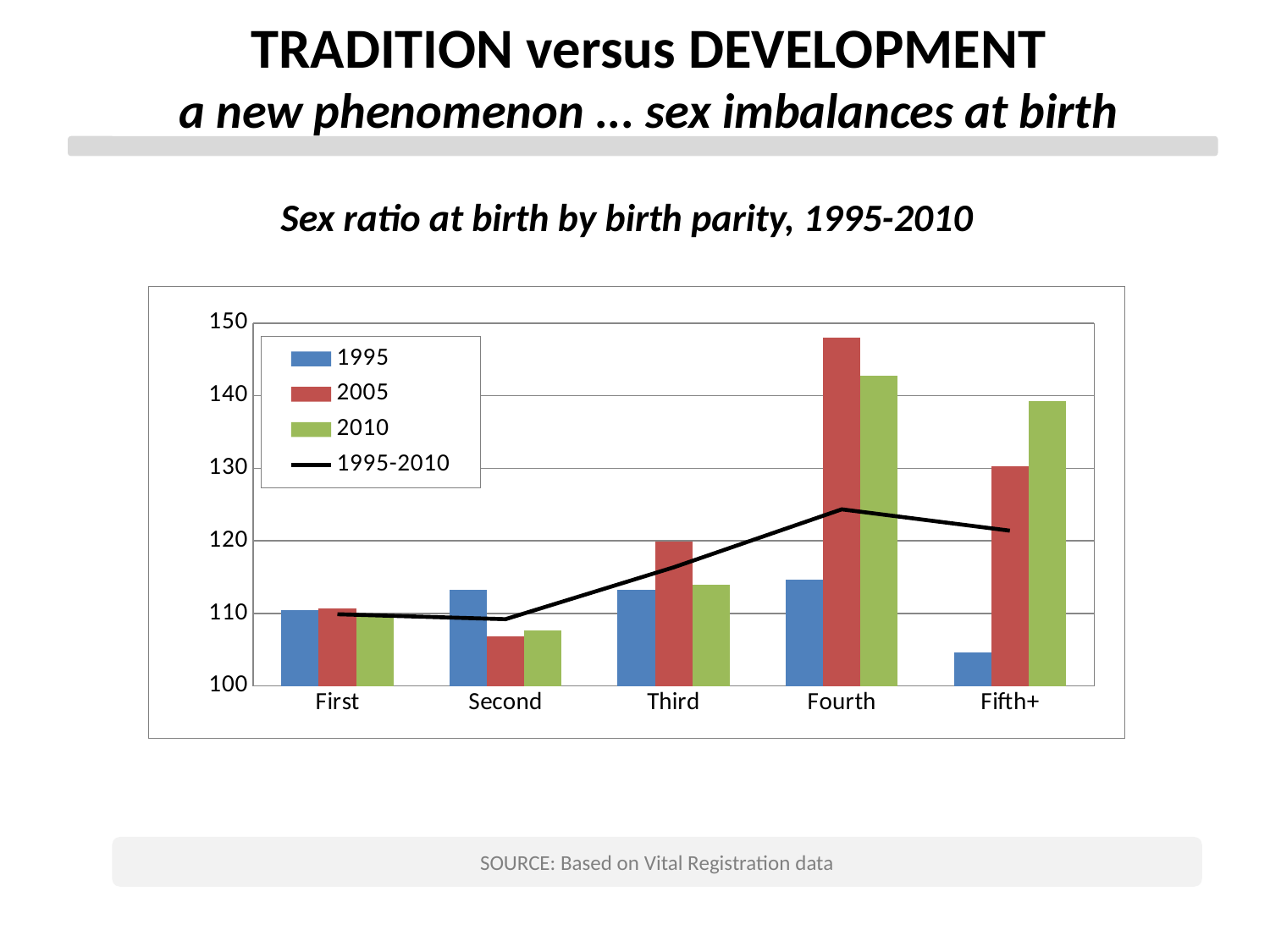
Is the 2005 value for Fourth greater or less than 140? greater For Fifth+, which series has the larger value, 2005 or 2010? 2010 What kind of chart is shown on the slide? A bar chart with a line Is the 2010 value for Fifth+ greater or less than 130? greater Does the 1995-2010 line rise or fall from Second to Fourth? rise How many series does the legend list? 4 Is the 1995 value for Fifth+ greater or less than 110? less What is the title of the chart? Sex ratio at birth by birth parity, 1995-2010 Which birth parity has the lowest sex ratio for 2005? Second Which birth parity has the highest sex ratio for 2005? Fourth How many birth parity categories are shown on the x axis? 5 Which birth parity has the lowest sex ratio for 1995? Fifth+